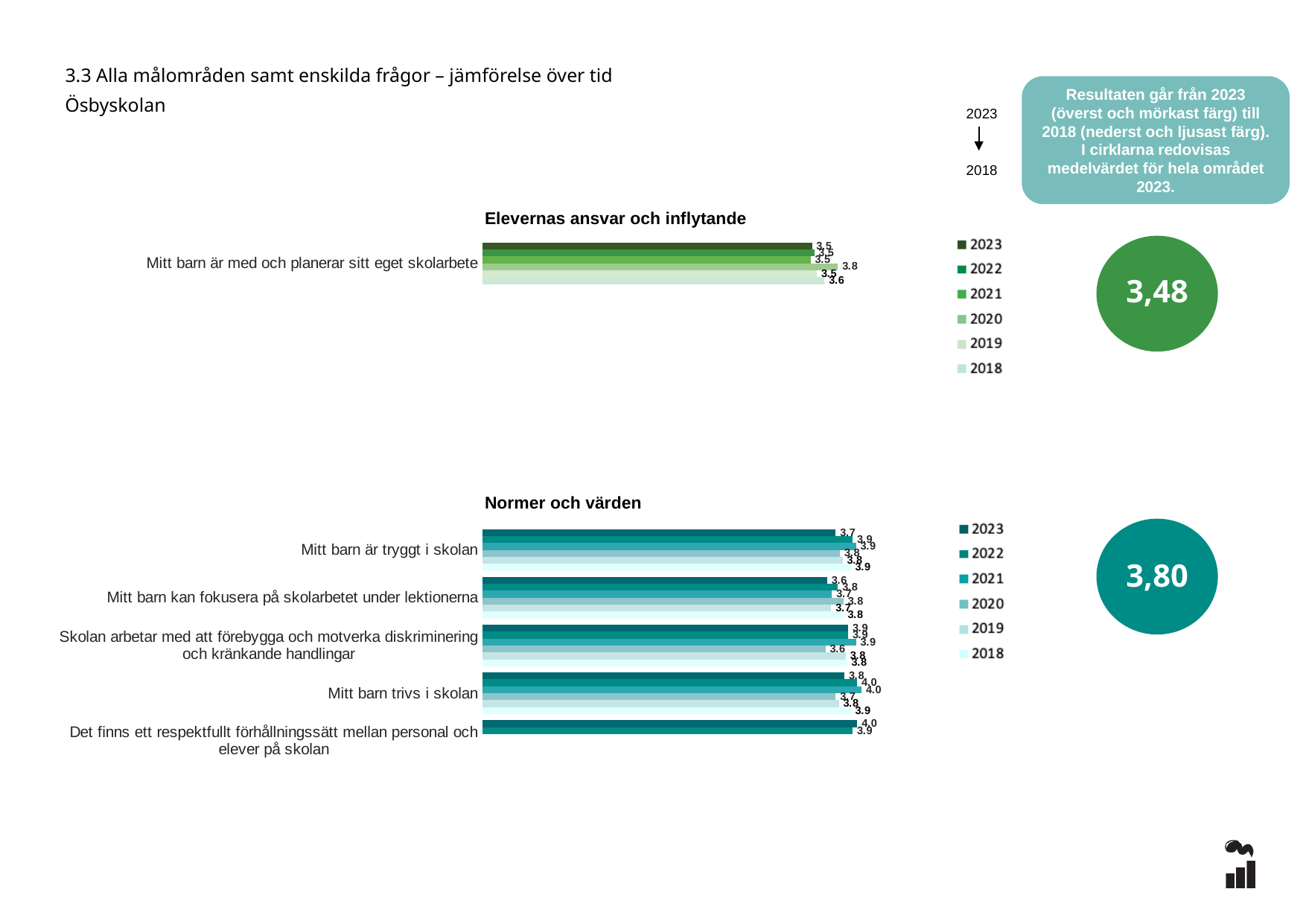
In the "Normer och värden" chart, what is the 2023 value for "Mitt barn är tryggt i skolan"? 3.7 In the "Normer och värden" chart, which is larger for "Mitt barn trivs i skolan": the 2023 value or the 2022 value? 2022 In the "Elevernas ansvar och inflytande" chart, which year has the highest value for "Mitt barn är med och planerar sitt eget skolarbete"? 2020 In the "Normer och värden" chart, which year has the lowest value for "Mitt barn kan fokusera på skolarbetet under lektionerna"? 2023 What kind of chart is used under the title "Normer och värden"? bar chart In the "Normer och värden" chart, how many categories (questions) are listed? 5 In the "Normer och värden" chart, what is the 2020 value for "Skolan arbetar med att förebygga och motverka diskriminering och kränkande handlingar"? 3.6 How many series does the legend of the "Elevernas ansvar och inflytande" chart list? 6 In the "Elevernas ansvar och inflytande" chart, what is the 2020 value for "Mitt barn är med och planerar sitt eget skolarbete"? 3.8 In the "Normer och värden" chart, what is the 2023 value for "Det finns ett respektfullt förhållningssätt mellan personal och elever på skolan"? 4.0 In the "Normer och värden" chart, what is the difference between the 2023 and 2022 values for "Det finns ett respektfullt förhållningssätt mellan personal och elever på skolan"? 0.1 What mean value is shown in the circle next to the "Normer och värden" chart? 3,80